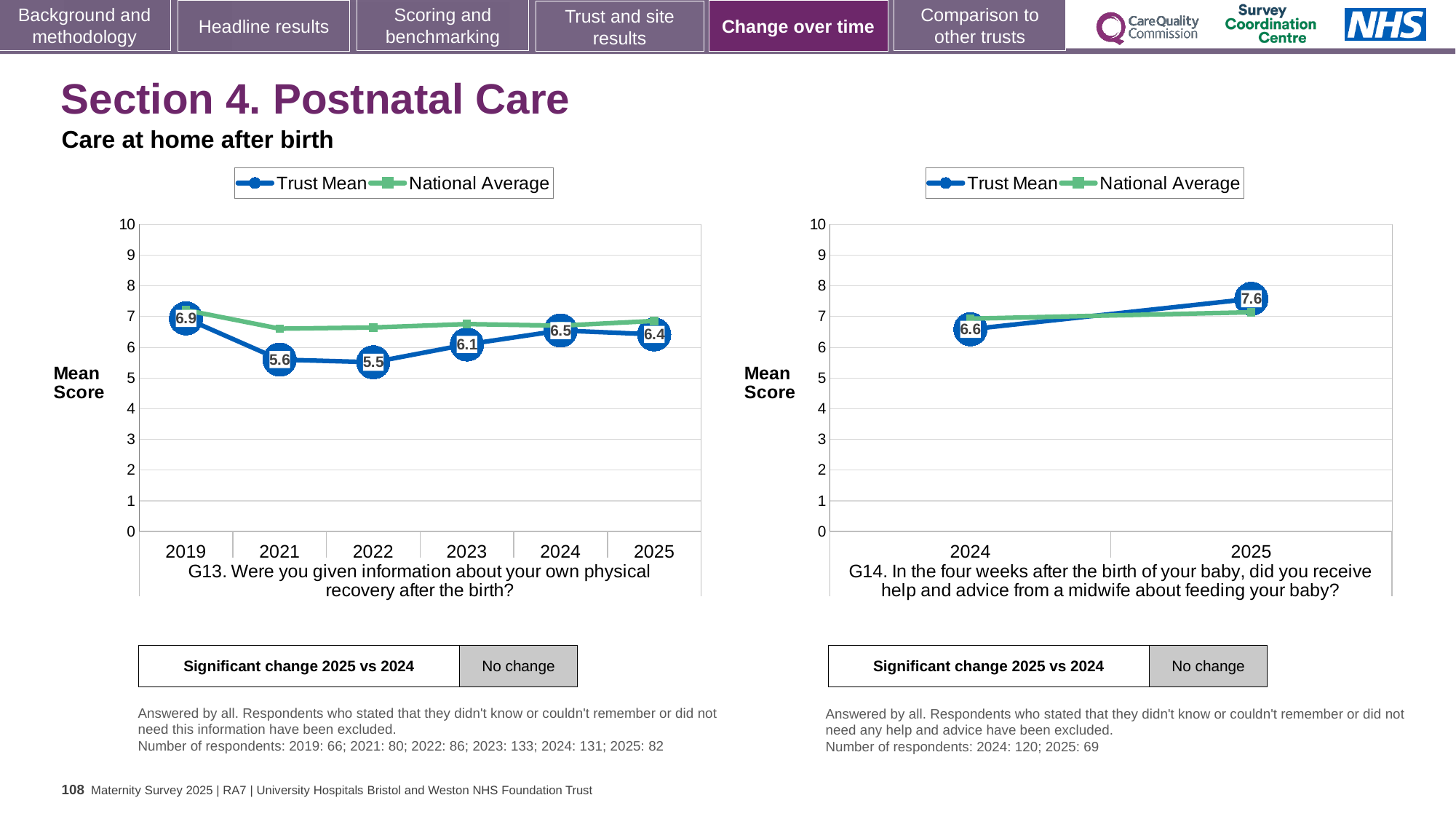
In the G14 chart, does the Trust Mean rise or fall from 2024 to 2025? rise In the G13 chart, what is the Trust Mean for 2022? 5.5 In the G13 chart, what is the Trust Mean for 2025? 6.4 In the G13 chart, which year has the lowest Trust Mean? 2022 In the G13 chart, which year has the highest Trust Mean? 2019 How many series does the legend of the G13 chart list? 2 In the G14 chart, what is the Trust Mean for 2025? 7.6 In the G14 chart, is the National Average for 2025 greater or less than 8? less In the G13 chart, what is the Trust Mean for 2019? 6.9 In the G14 chart, what is the difference between the Trust Mean for 2025 and 2024? 1.0 In the G13 chart, what is the difference between the Trust Mean for 2019 and 2022? 1.4 In the G13 chart, how many years are shown on the x axis? 6